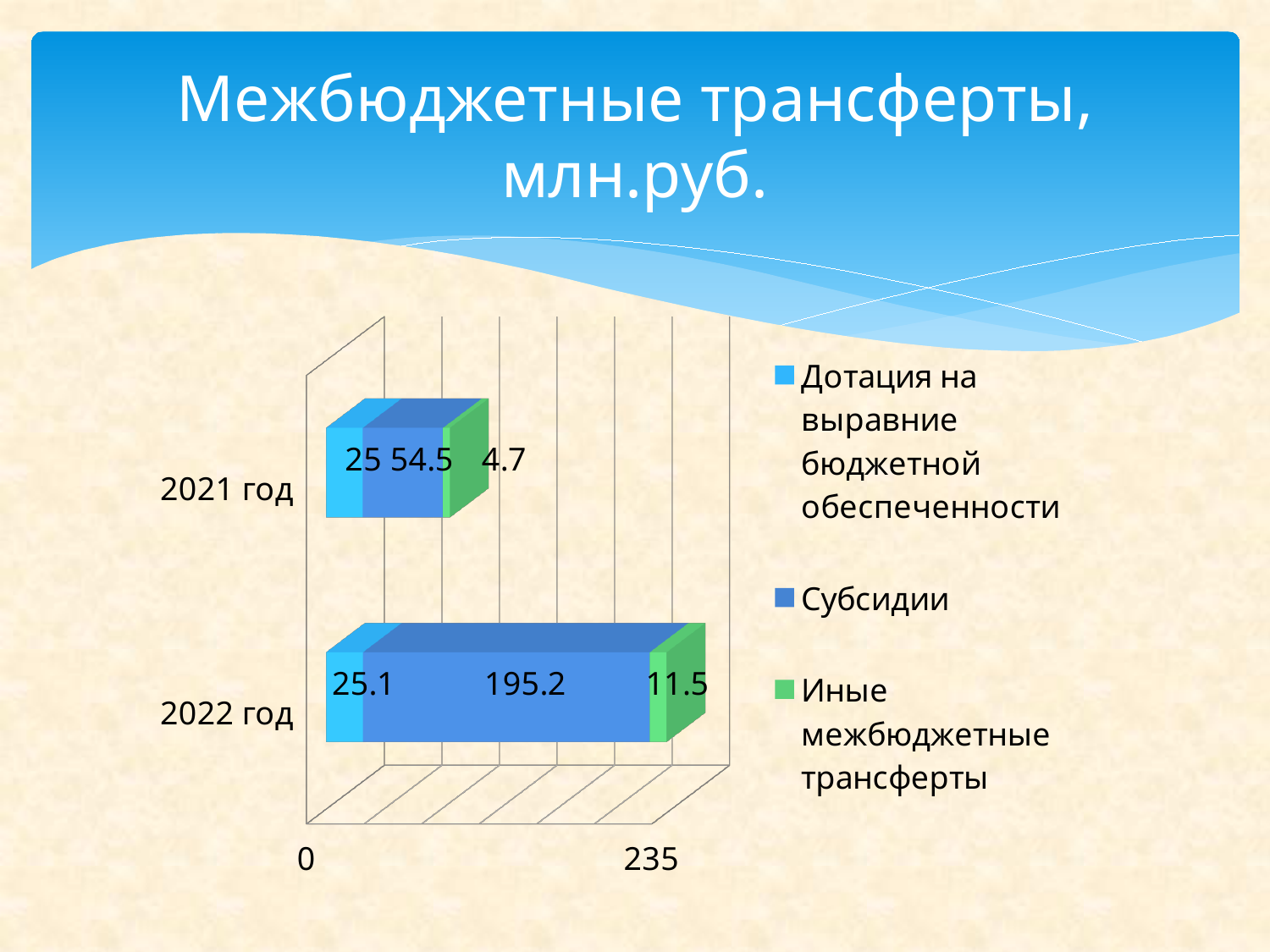
What is the value of Субсидии for 2022 год? 195.2 Which year has the larger value for Субсидии? 2022 год What is the value of Субсидии for 2021 год? 54.5 What is the value of Дотация на выравние бюджетной обеспеченности for 2021 год? 25 What is the total of the stacked bar for 2021 год? 84.2 How many categories (years) are shown on the chart? 2 What is the value of Иные межбюджетные трансферты for 2021 год? 4.7 What is the difference between the Субсидии values for 2022 год and 2021 год? 140.7 What kind of chart is shown on the slide? Stacked bar chart What is the total of the stacked bar for 2022 год? 231.8 How many series does the legend list? 3 What is the value of Иные межбюджетные трансферты for 2022 год? 11.5